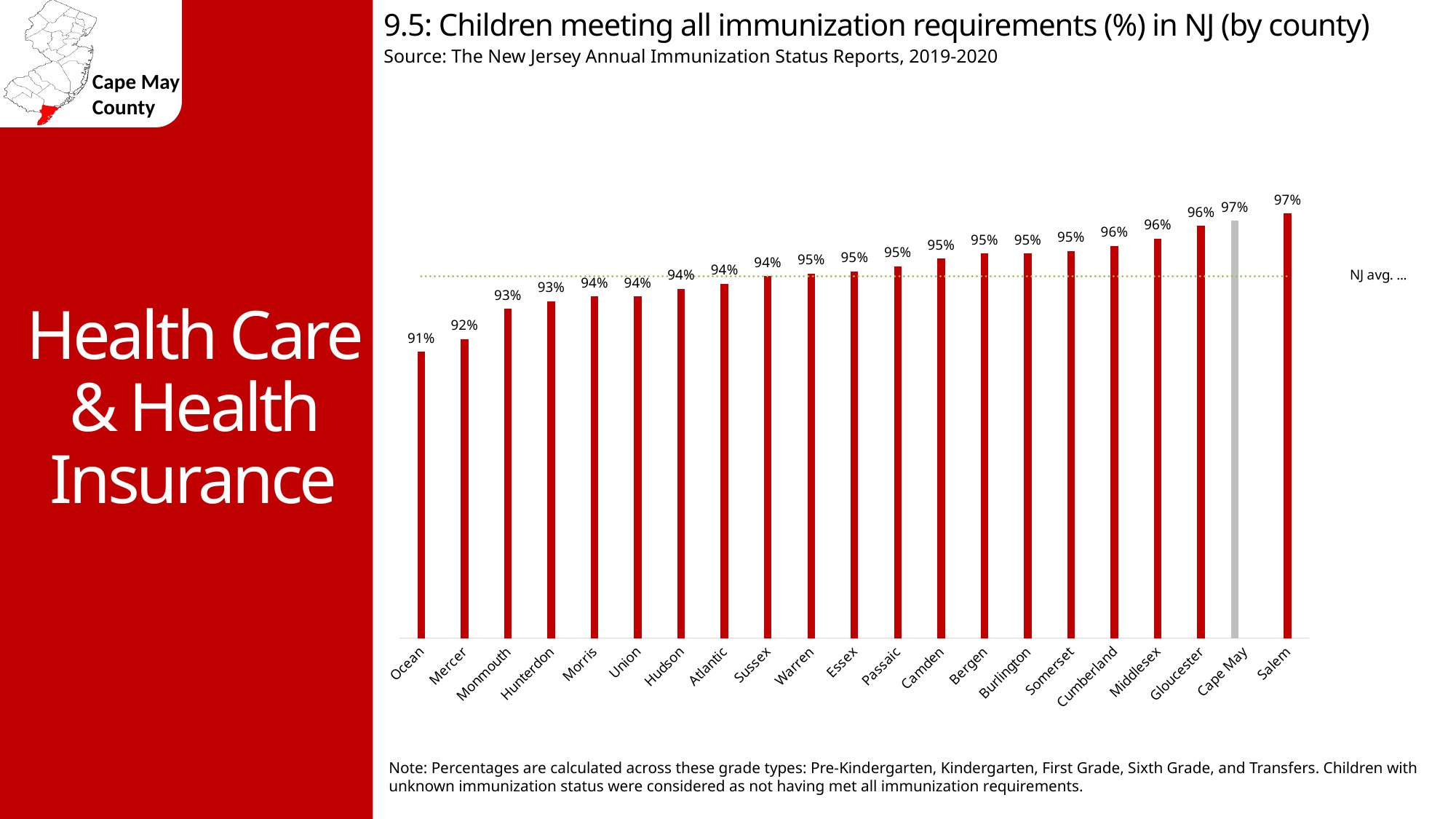
Which county has the lowest percentage of children meeting all immunization requirements? Ocean What is the difference in percentage points between Salem and Ocean? 6 percentage points Which has a higher value, Ocean or Mercer? Mercer How many counties are shown in the chart? 21 What percentage of children in Cape May County met all immunization requirements? 97% Which has a higher value, Monmouth or Cumberland? Cumberland Do the values rise or fall moving from left to right along the x axis? Rise What is the value for Hunterdon County? 93% What is the value shown for Ocean County? 91% What is the difference in percentage points between Cape May and Mercer? 5 percentage points What percentage is shown for Middlesex County? 96% What kind of chart is used on this slide? Bar chart